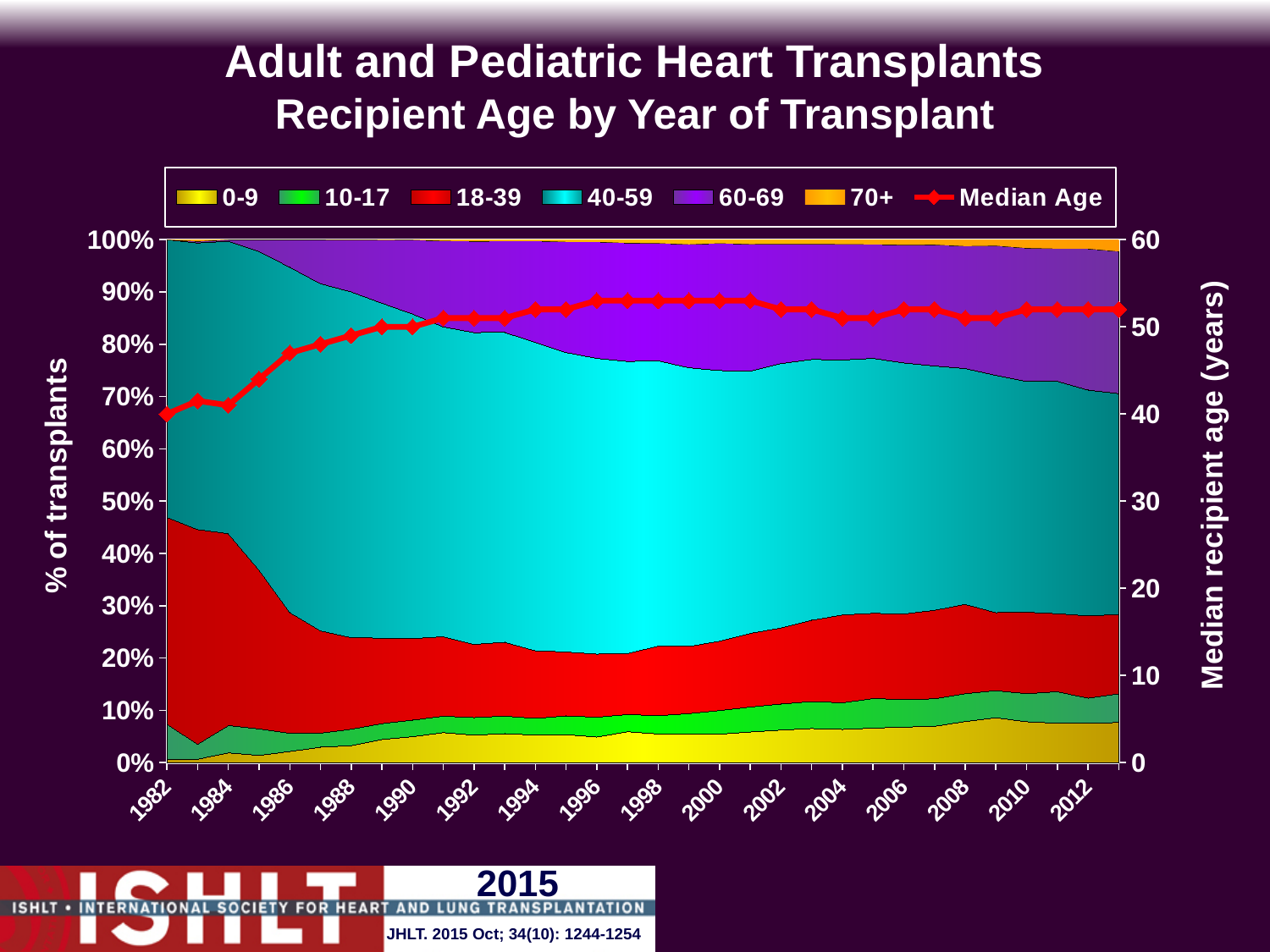
Is the median recipient age in 2000 greater or less than 50 years? greater Is the share of transplants for the 18-39 age group in 1982 greater or less than 30%? greater What kind of chart is shown on the slide? Stacked area chart with a line for median age Does the share of transplants for the 18-39 age group rise or fall between 1982 and 1994? fall Is the median recipient age in 1982 greater or less than 50 years? less Which age group accounts for the largest share of transplants in 2012? 40-59 What is the title of the chart? Adult and Pediatric Heart Transplants Recipient Age by Year of Transplant How many entries does the legend list? 7 Does the median recipient age rise or fall between 1982 and 1996? rise Which age group accounts for the smallest share of transplants in 2012? 70+ How many year labels are shown on the x axis? 16 What is the label of the right-hand vertical axis? Median recipient age (years)